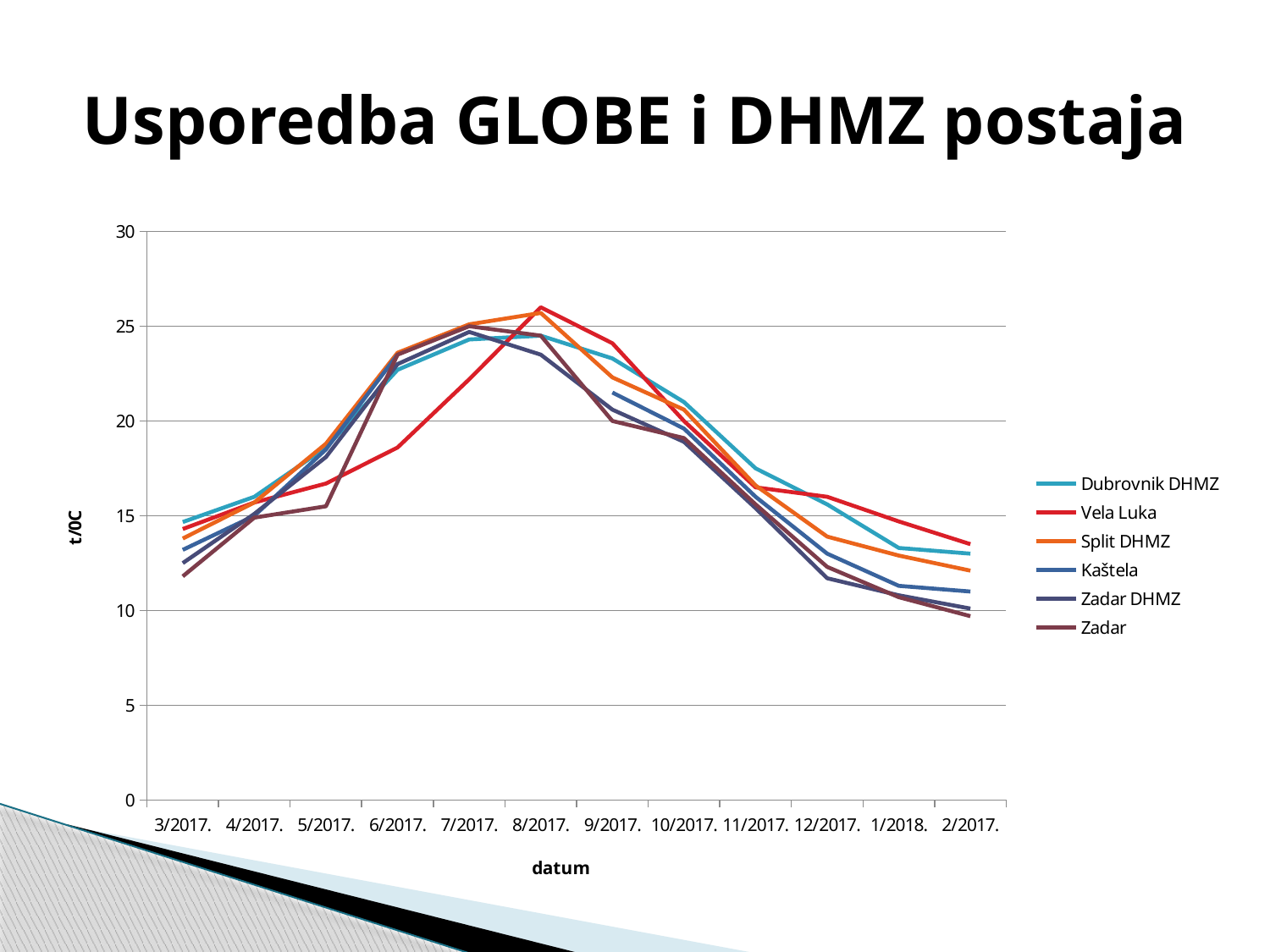
What is the label of the x axis? datum Is the value for Kaštela at 2/2017. greater or less than 15? less Does the Vela Luka series rise or fall from 8/2017. to 2/2017.? fall Is the value for Vela Luka at 8/2017. greater or less than 25? greater How many dates are shown along the x axis? 12 At 6/2017., which is larger: Split DHMZ or Vela Luka? Split DHMZ Is the value for Zadar at 3/2017. greater or less than 15? less Which series has the lowest value at 3/2017.? Zadar What is the title of the slide containing the chart? Usporedba GLOBE i DHMZ postaja How many series does the legend list? 6 What kind of chart is shown on the slide? line chart At which date does the Vela Luka series reach its highest value? 8/2017.